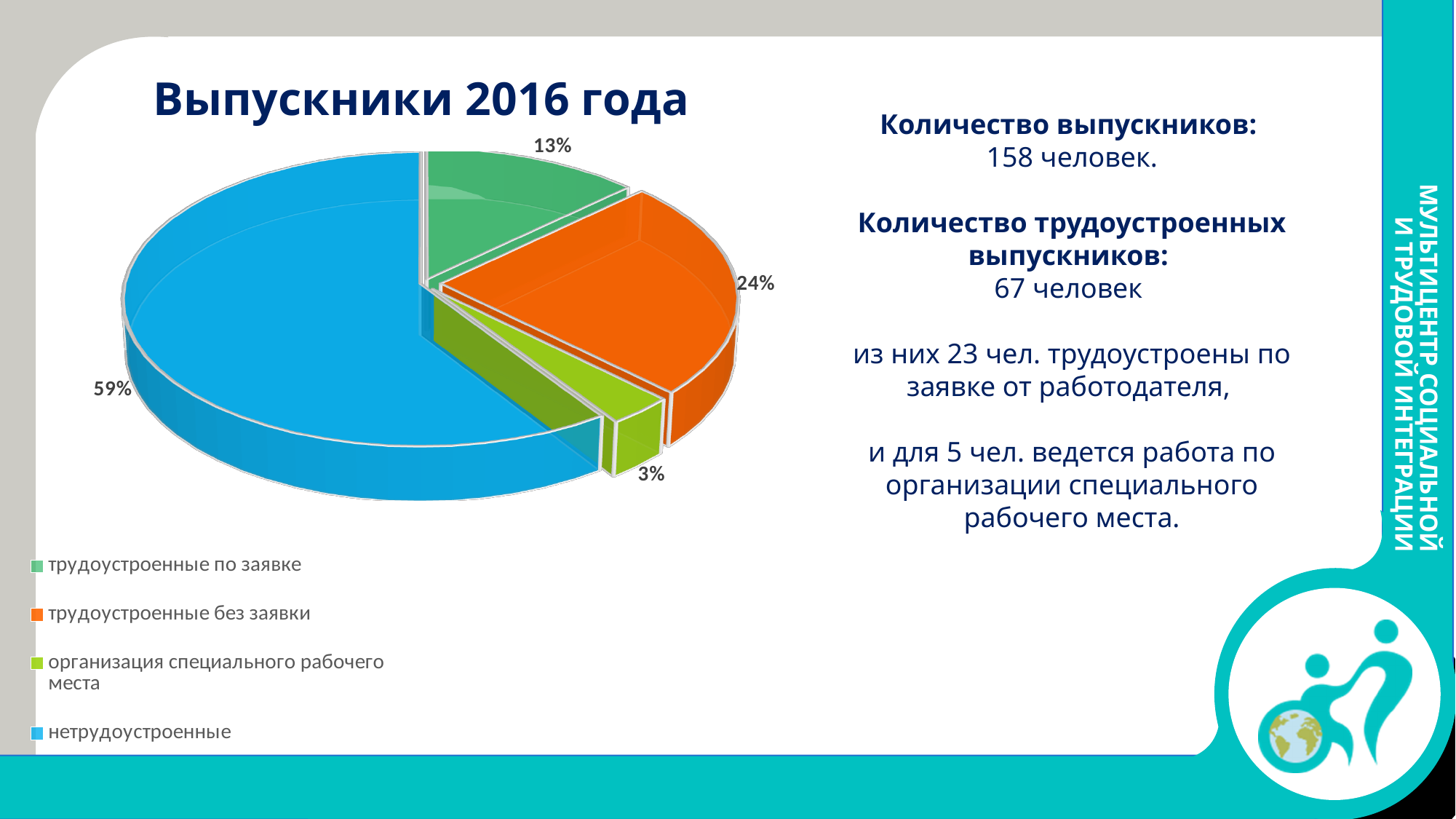
Which category has the smallest slice of the pie? организация специального рабочего места How many slices does the pie chart have? 4 What share of the pie is labelled "трудоустроенные без заявки"? 24% What type of chart is shown on the slide? Pie chart What share of the pie is labelled "нетрудоустроенные"? 59% Which category has the largest slice of the pie? нетрудоустроенные What share of the pie is labelled "трудоустроенные по заявке"? 13% What colour is the slice for "нетрудоустроенные"? Blue What is the title of the chart? Выпускники 2016 года What is the difference in percentage points between "нетрудоустроенные" and "трудоустроенные без заявки"? 35 Which is larger: the slice for "трудоустроенные по заявке" or the slice for "трудоустроенные без заявки"? трудоустроенные без заявки